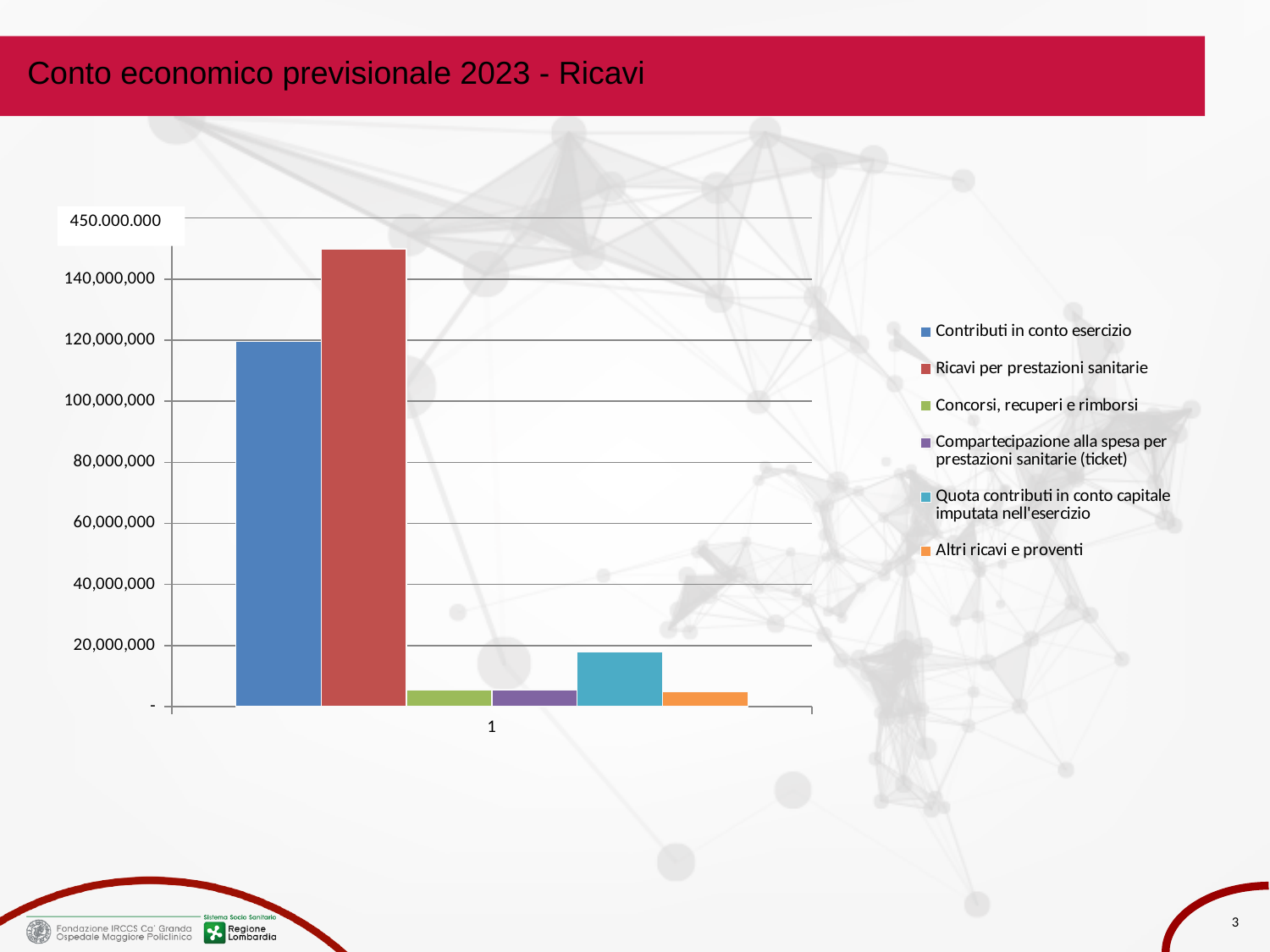
Is the value for Contributi in conto esercizio greater or less than 100,000,000? greater Which series is shown in red in the chart? Ricavi per prestazioni sanitarie Which series has the highest value in the chart? Ricavi per prestazioni sanitarie Which is larger, the value for Contributi in conto esercizio or the value for Ricavi per prestazioni sanitarie? Ricavi per prestazioni sanitarie What kind of chart is shown on the slide? bar chart Is the value for Ricavi per prestazioni sanitarie greater or less than 140,000,000? greater Is the value for Altri ricavi e proventi greater or less than 20,000,000? less What is the title of the slide containing the chart? Conto economico previsionale 2023 - Ricavi How many series does the legend list? 6 Which is larger, the value for Quota contributi in conto capitale imputata nell'esercizio or the value for Concorsi, recuperi e rimborsi? Quota contributi in conto capitale imputata nell'esercizio How many categories are shown on the x axis of the chart? 1